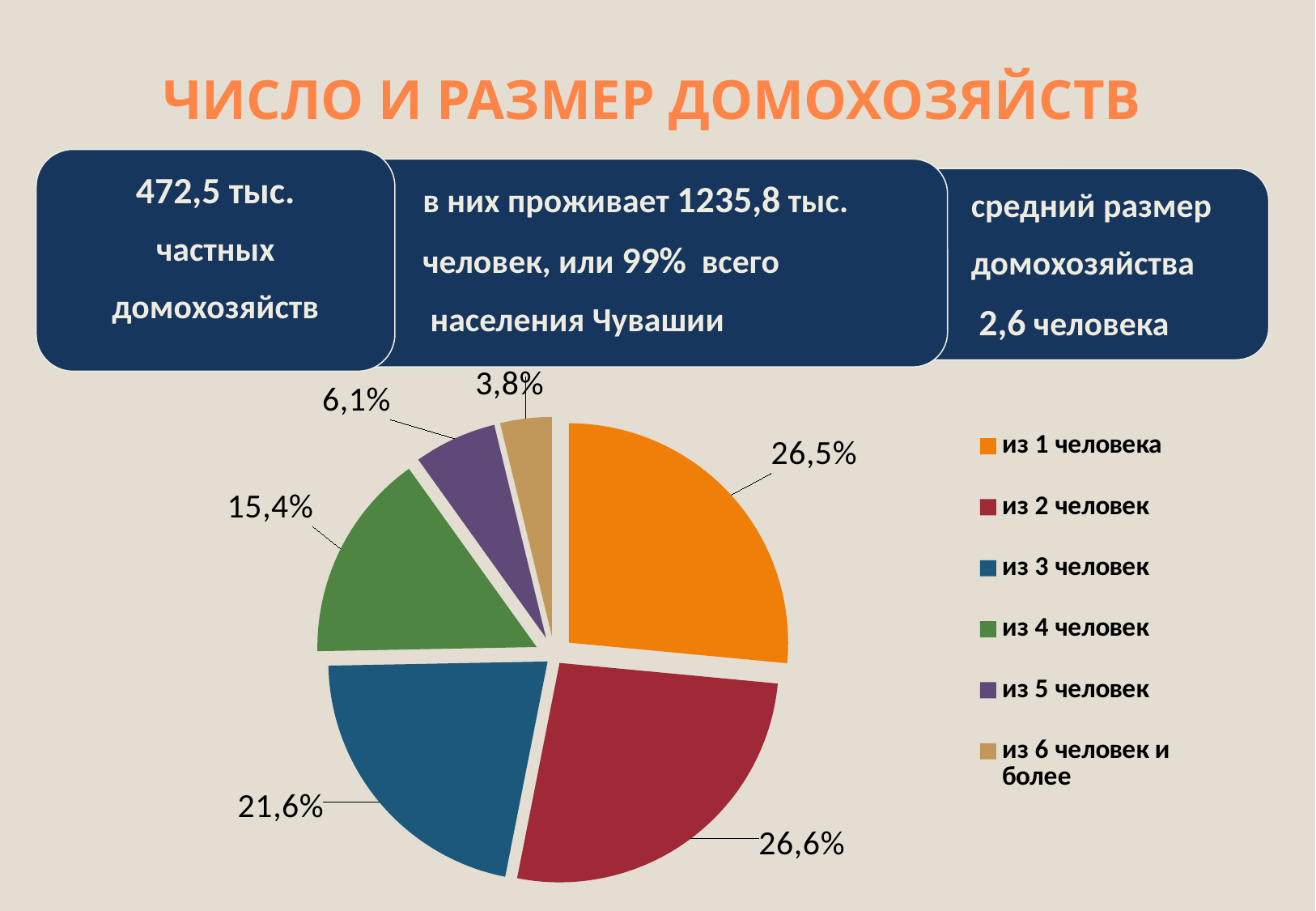
What is the difference between the share of households of 3 people and households of 5 people? 15,5% Which household size category has the smallest share of the pie? из 6 человек и более What share of households consists of 6 or more people (из 6 человек и более)? 3,8% What share of households consists of 1 person (из 1 человека)? 26,5% What share of households consists of 5 people (из 5 человек)? 6,1% Which is larger: the share of households of 3 people or of 4 people? из 3 человек What share of households consists of 2 people (из 2 человек)? 26,6% What kind of chart is shown on the slide? pie chart What share of households consists of 4 people (из 4 человек)? 15,4% What colour is the slice for households of 4 people (из 4 человек)? green How many categories does the pie chart have? 6 What share of households consists of 3 people (из 3 человек)? 21,6%